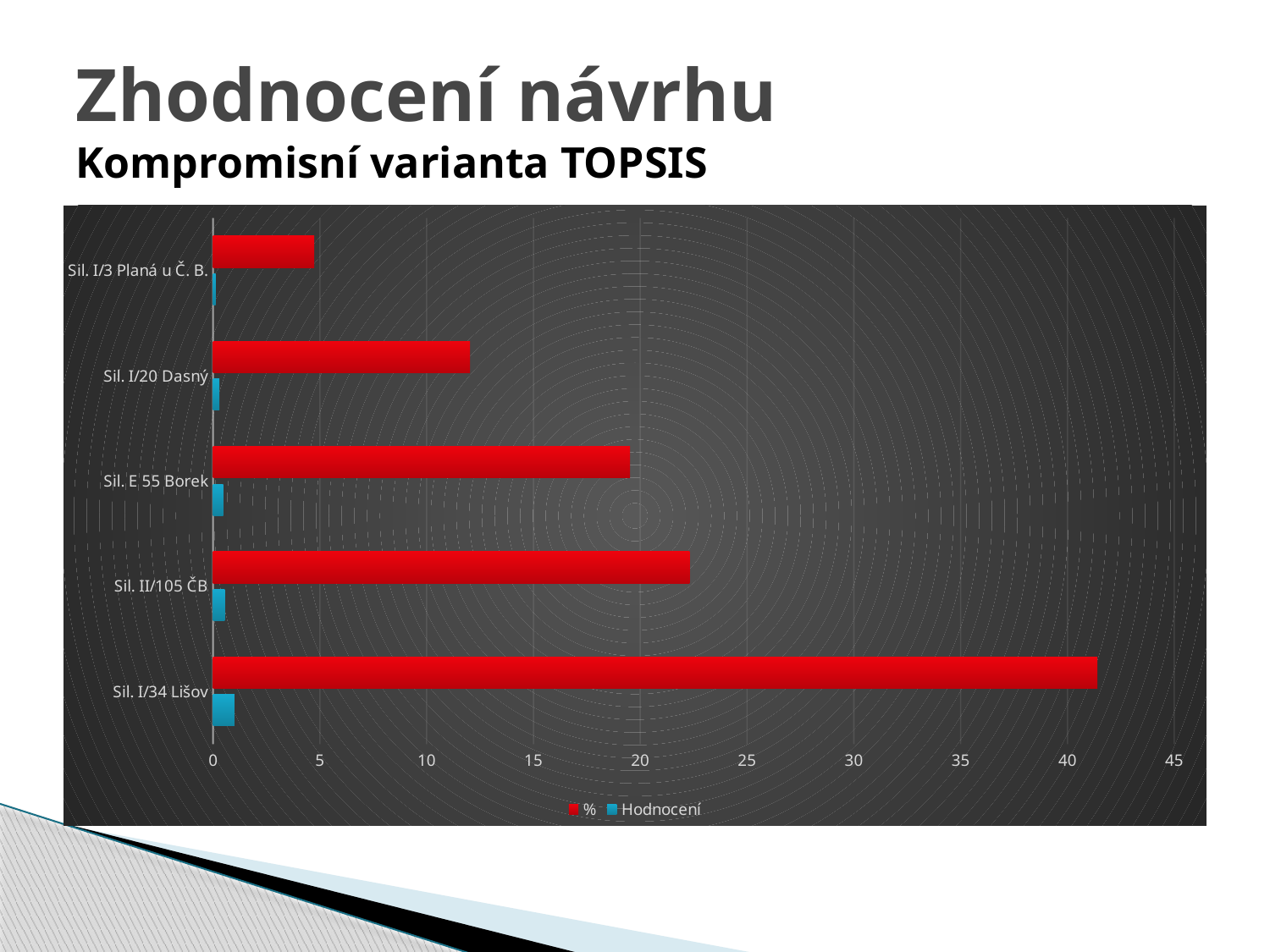
Is the % value for Sil. I/3 Planá u Č. B. greater or less than 5? less Which has the larger % value, Sil. II/105 ČB or Sil. I/34 Lišov? Sil. I/34 Lišov Which series is drawn in red? % Which category has the highest value for the % series? Sil. I/34 Lišov Which category has the lowest value for the % series? Sil. I/3 Planá u Č. B. What kind of chart is shown on the slide? bar chart Which has the larger % value, Sil. I/20 Dasný or Sil. E 55 Borek? Sil. E 55 Borek How many series does the legend list? 2 How many categories are plotted on the chart? 5 Is the % value for Sil. II/105 ČB greater or less than 20? greater What are the two legend entries of the chart? % and Hodnocení Is the % value for Sil. I/34 Lišov greater or less than 40? greater